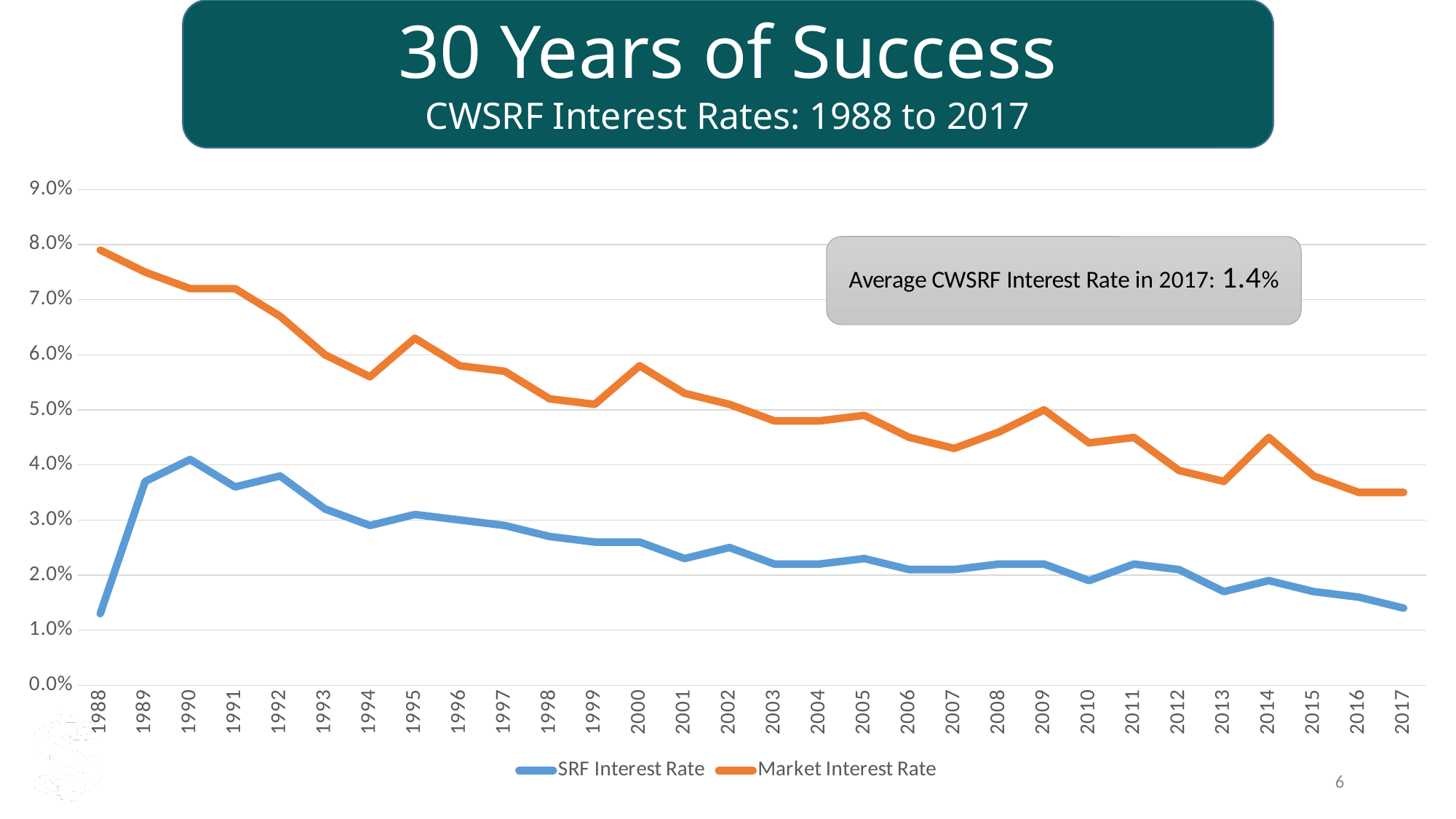
Does the Market Interest Rate generally rise or fall from 1988 to 2017? fall Which colour is used for the SRF Interest Rate line? Blue In 2000, which series has the higher value, SRF Interest Rate or Market Interest Rate? Market Interest Rate In which year is the Market Interest Rate highest? 1988 What is the average CWSRF (SRF) interest rate in 2017, as stated on the slide? 1.4% Is the Market Interest Rate in 2017 greater or less than 4.0%? less Is the Market Interest Rate in 1988 greater or less than 7.0%? greater In which year is the SRF Interest Rate highest? 1990 Is the SRF Interest Rate in 1988 greater or less than 2.0%? less How many years are plotted along the x axis? 30 What kind of chart is shown on the slide? Line chart How many series does the legend list? 2